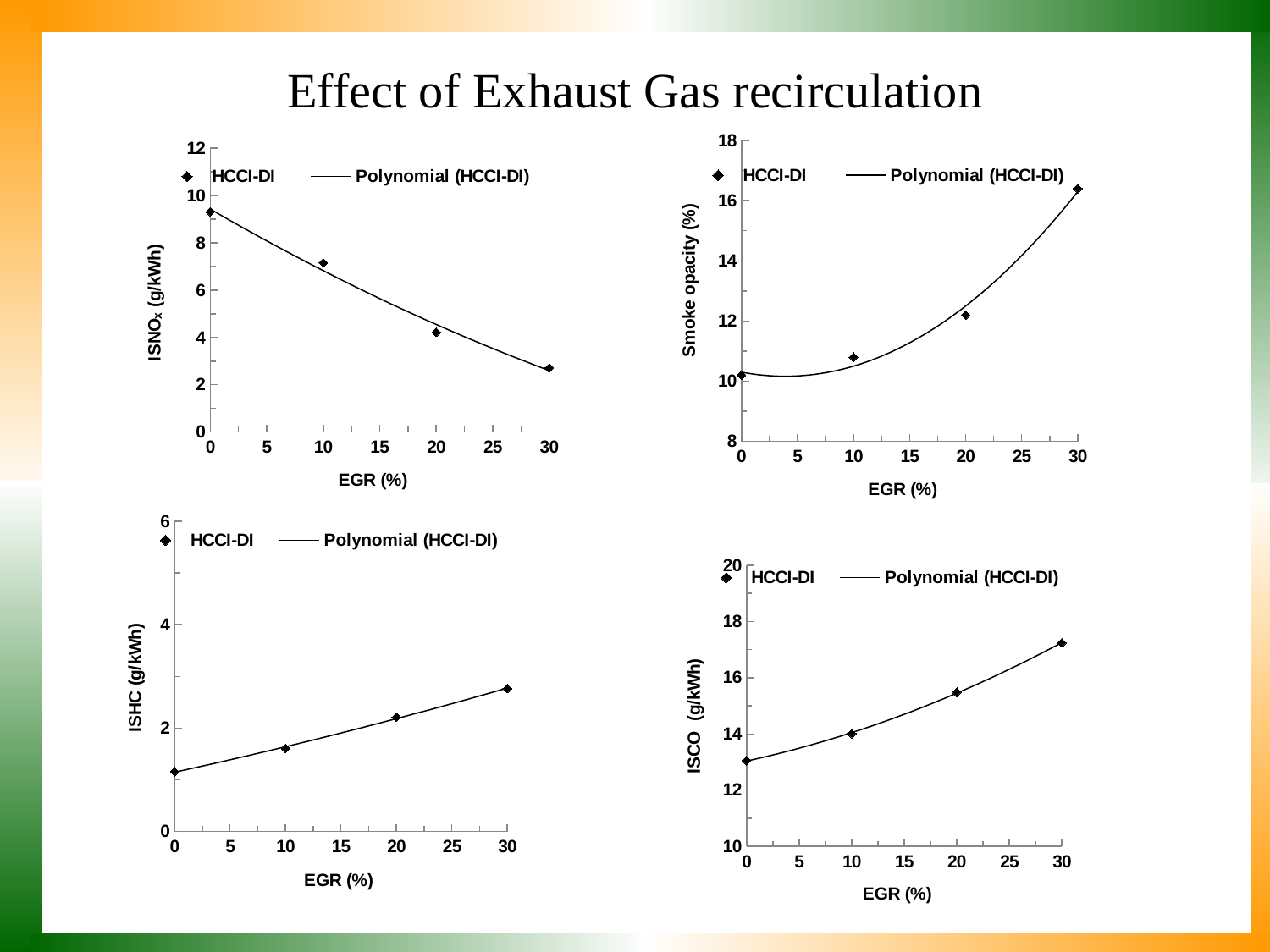
In the top-right Smoke opacity chart, at which EGR (%) is smoke opacity lowest? 0 In the bottom-right ISCO chart, is the value at EGR 0% greater or less than 14? less In the bottom-right ISCO chart, which has the larger ISCO value, EGR 20% or EGR 30%? EGR 30% In the top-left ISNOx chart, how many data points are plotted? 4 What kind of chart is the top-left chart (ISNOx vs EGR)? scatter chart with a polynomial trendline In the top-left ISNOx chart, is the value at EGR 0% greater or less than 8? greater In the top-left ISNOx chart, do the values rise or fall as EGR increases? fall In the top-right Smoke opacity chart, do the values rise or fall as EGR increases? rise In the bottom-left ISHC chart, how many entries does the legend list? 2 In the top-left ISNOx chart, at which EGR (%) is ISNOx highest? 0 In the bottom-left ISHC chart, is the value at EGR 30% greater or less than 2? greater